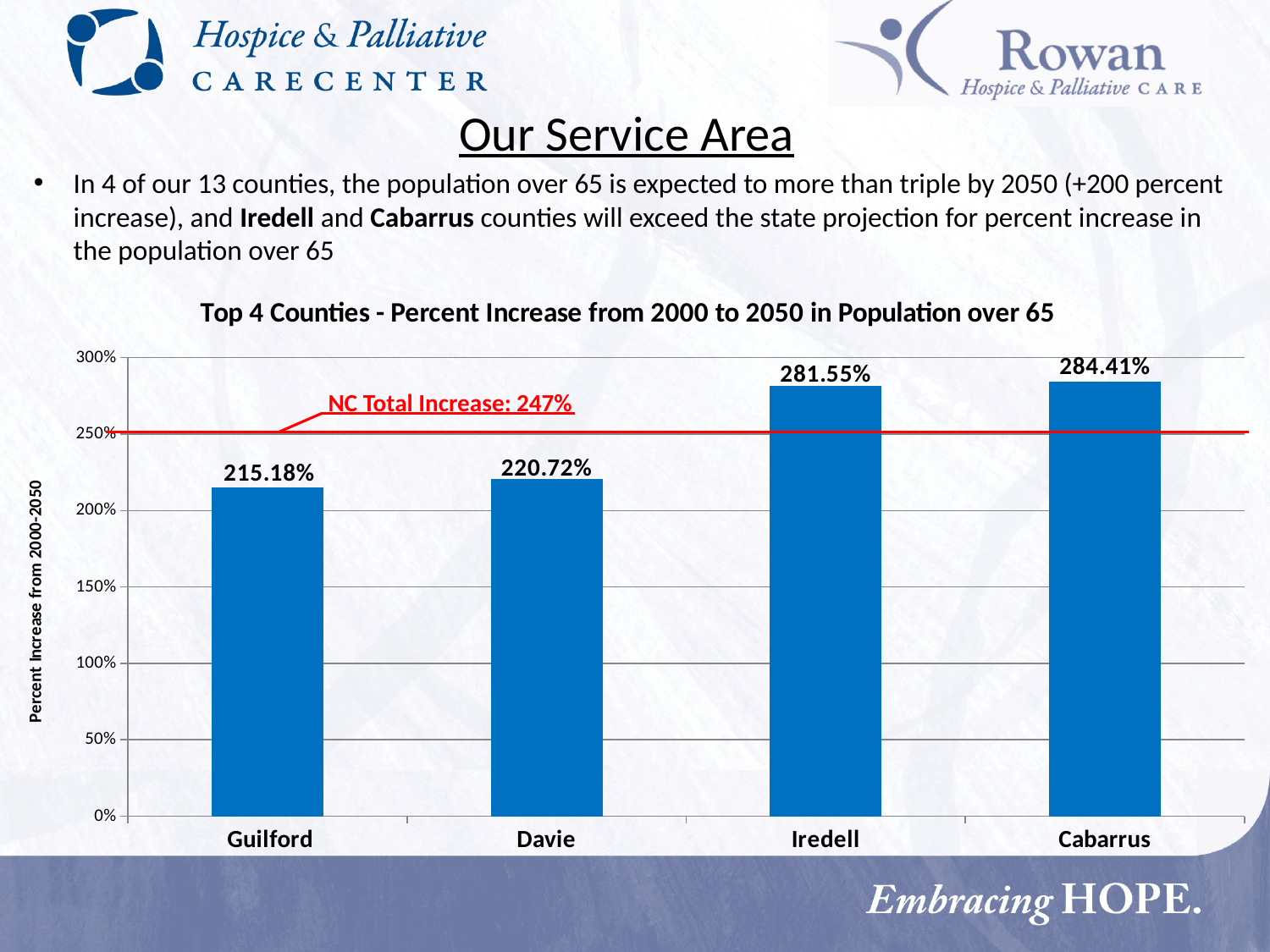
How many counties are shown in the chart? 4 What is the difference between the percent increase for Davie and Guilford? 5.54% What is the percent increase shown for Cabarrus? 284.41% Which county has the lowest percent increase? Guilford What is the percent increase shown for Guilford? 215.18% Which county has the highest percent increase? Cabarrus What is the percent increase shown for Davie? 220.72% What value does the red horizontal line labelled NC Total Increase represent? 247% What is the percent increase shown for Iredell? 281.55% What kind of chart is shown on the slide? Bar chart Which has a larger percent increase, Iredell or Davie? Iredell What is the difference between the percent increase for Cabarrus and Guilford? 69.23%